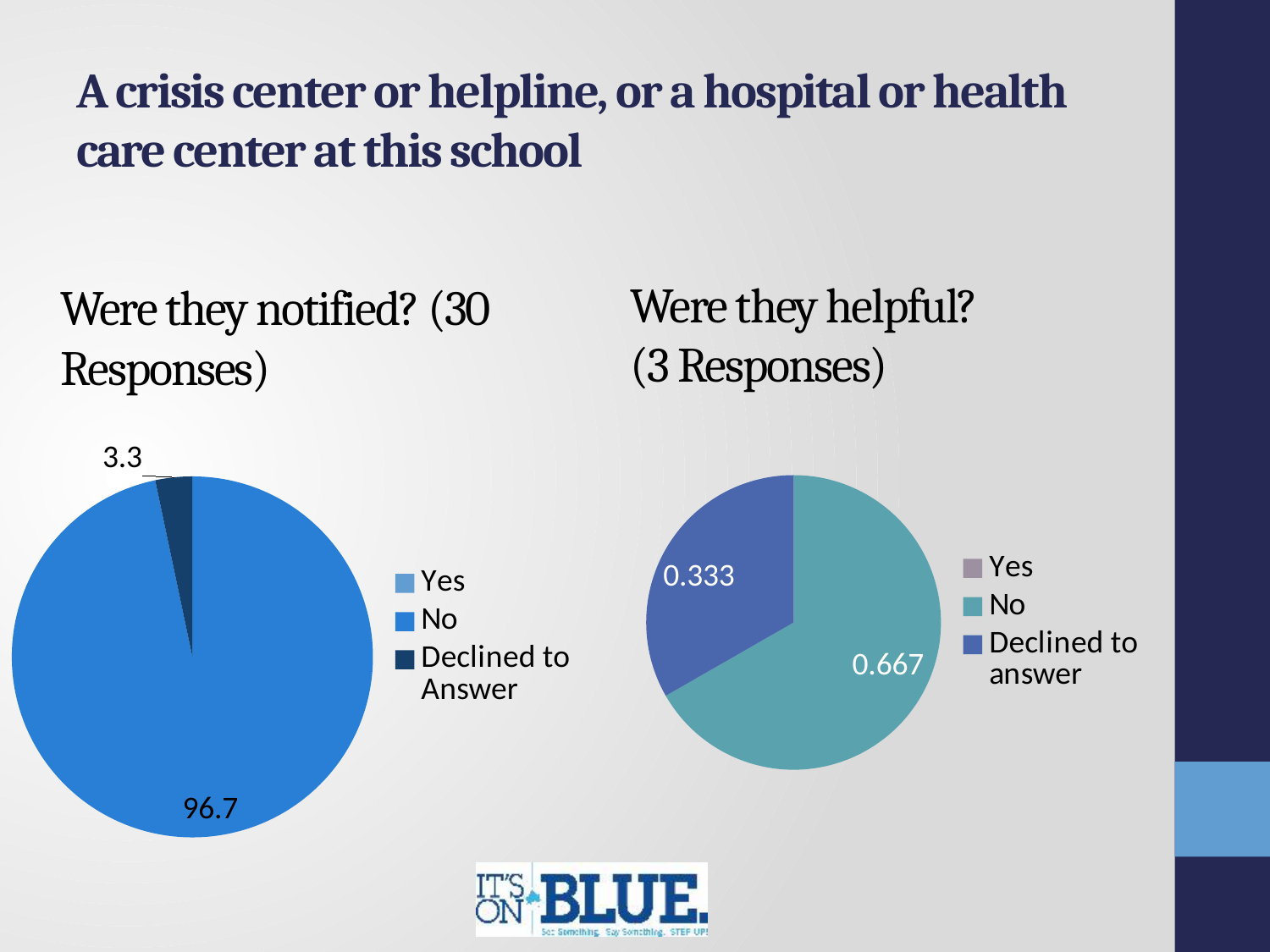
In the 'Were they notified?' chart, what is the difference between the No value and the Declined to Answer value? 93.4 In the 'Were they notified?' chart, what value is shown for No? 96.7 How many responses does the 'Were they notified?' chart title say it is based on? 30 In the 'Were they helpful?' chart, what value is shown for Declined to answer? 0.333 In the 'Were they helpful?' chart, which category has the largest slice? No In the 'Were they notified?' chart, which category has the largest slice? No How many responses does the 'Were they helpful?' chart title say it is based on? 3 In the 'Were they notified?' chart, what value is shown for Declined to Answer? 3.3 In the 'Were they helpful?' chart, what value is shown for No? 0.667 In the 'Were they helpful?' chart, which is larger, No or Declined to answer? No What type of chart is used for 'Were they helpful?'? Pie chart How many entries does the legend of the 'Were they notified?' chart list? 3